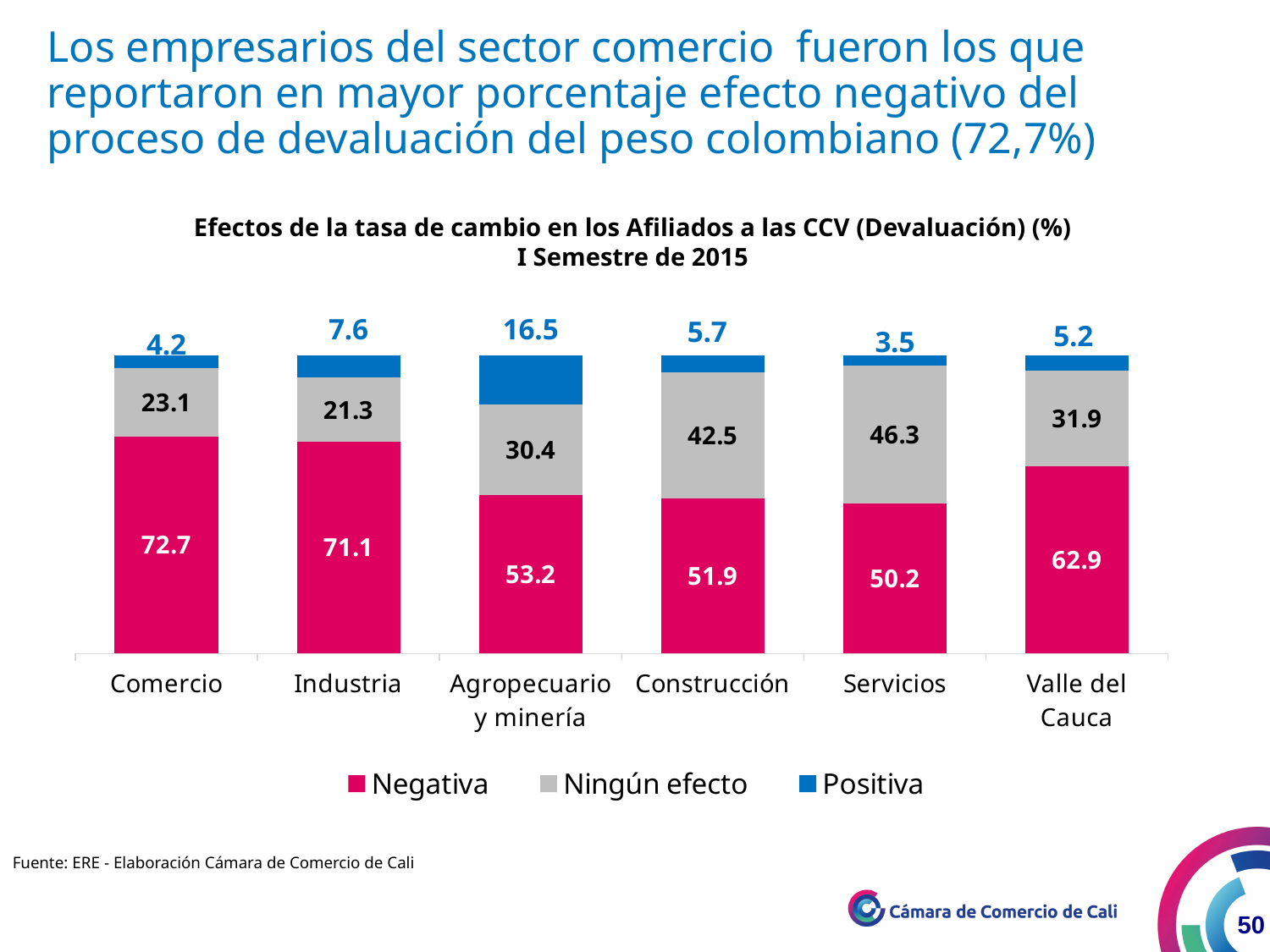
How many series does the legend list? 3 Which category has the lowest 'Positiva' value? Servicios What is the 'Negativa' value for Comercio? 72.7 What type of chart is shown on the slide? Stacked bar chart How many categories are shown on the x axis? 6 Which category has the highest 'Negativa' value? Comercio What is the 'Ningún efecto' value for Servicios? 46.3 Which series is shown in blue in the legend? Positiva What is the 'Positiva' value for Agropecuario y minería? 16.5 What is the total of the stacked bar for Industria? 100.0 What is the difference between the 'Negativa' values for Comercio and Servicios? 22.5 Which is larger: the 'Ningún efecto' value for Construcción or for Valle del Cauca? Construcción